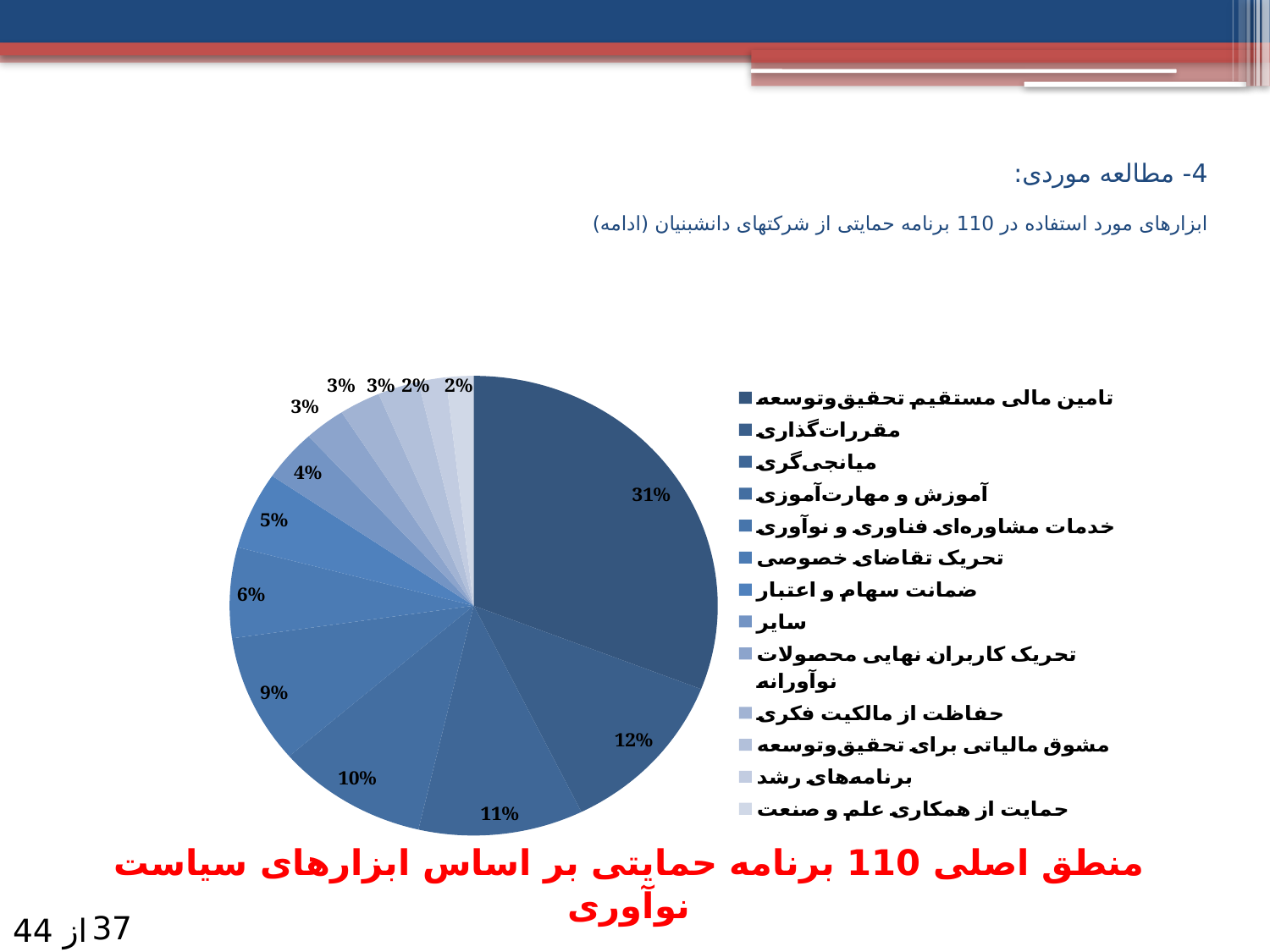
How many slices of the pie chart are labelled 3%? 3 How many slices does the pie chart have? 13 What is the largest percentage shown on the pie chart? 31% What is the difference in percentage points between the largest slice (31%) and the second largest slice (12%)? 19 percentage points What is the smallest percentage shown on the pie chart? 2% Which is larger: the slice labelled 10% or the slice labelled 9%? the slice labelled 10% What kind of chart is shown on the slide? pie chart Which legend category corresponds to the largest slice (31%) of the pie chart? تامین مالی مستقیم تحقیق‌وتوسعه What share of the pie does the slice for میانجی‌گری represent? 11% How many entries does the legend of the pie chart list? 13 What is the title written below the pie chart? منطق اصلی 110 برنامه حمایتی بر اساس ابزارهای سیاست نوآوری What share of the pie does the slice for مقررات‌گذاری represent? 12%